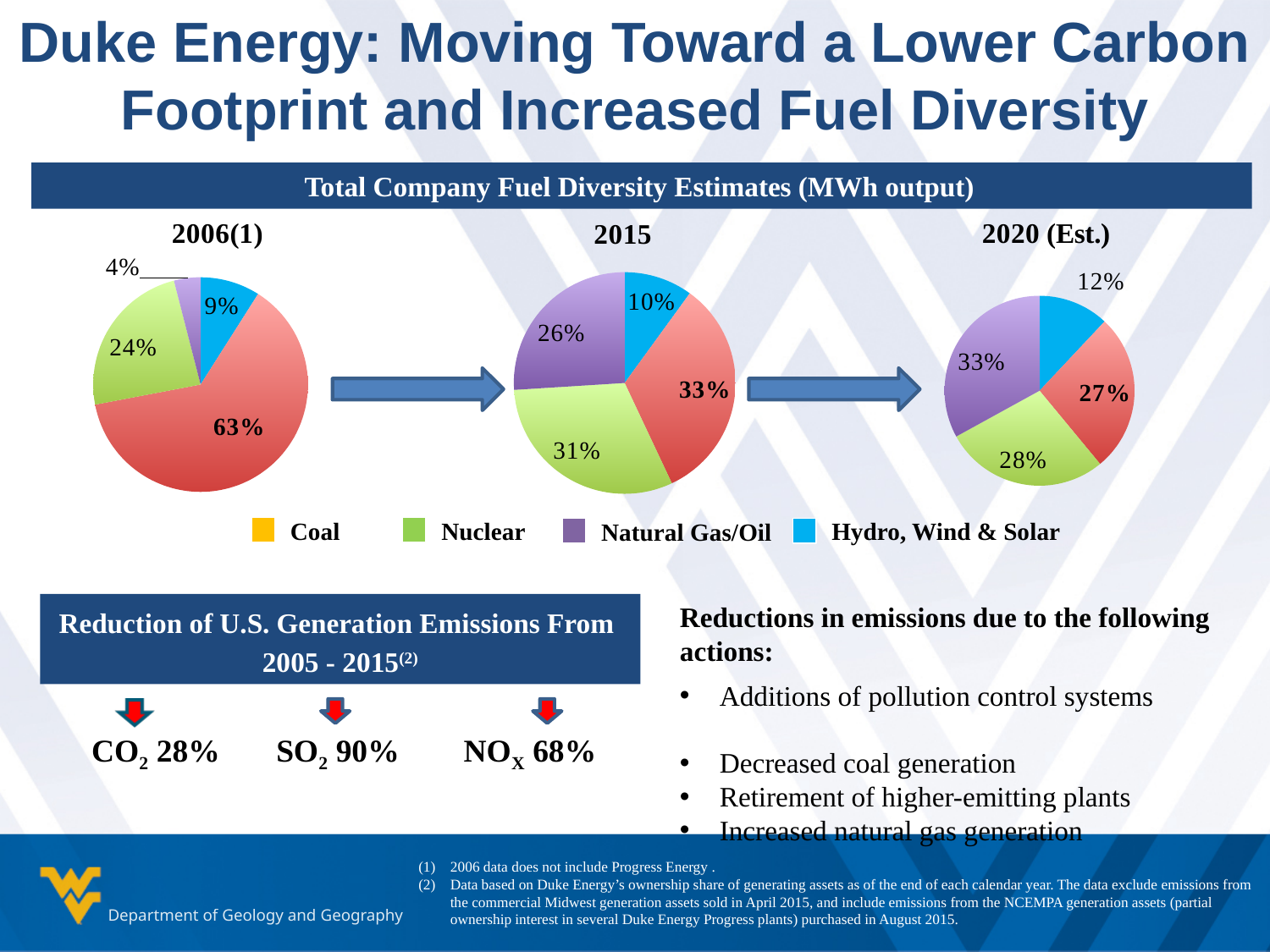
In the 2006(1) pie chart, what share is Nuclear? 24% How many percentage points higher is the Nuclear share in the 2015 pie chart than in the 2006(1) pie chart? 7 In the 2006(1) pie chart, what is the value of the smallest slice? 4% How many fuel categories does the legend below the pie charts list? 4 In the 2015 pie chart, what share is Natural Gas/Oil? 26% Across the 2006(1), 2015 and 2020 (Est.) pie charts, does the Hydro, Wind & Solar share rise or fall over time? Rise What is the title of the banner above the three pie charts? Total Company Fuel Diversity Estimates (MWh output) What kind of charts are used to show the Total Company Fuel Diversity Estimates? Pie charts In the 2006(1) pie chart, what is the value of the largest slice? 63% In the 2015 pie chart, which is larger: the Nuclear share or the Natural Gas/Oil share? Nuclear In the 2020 (Est.) pie chart, what share is Hydro, Wind & Solar? 12% In the 2020 (Est.) pie chart, which fuel category has the largest share? Natural Gas/Oil